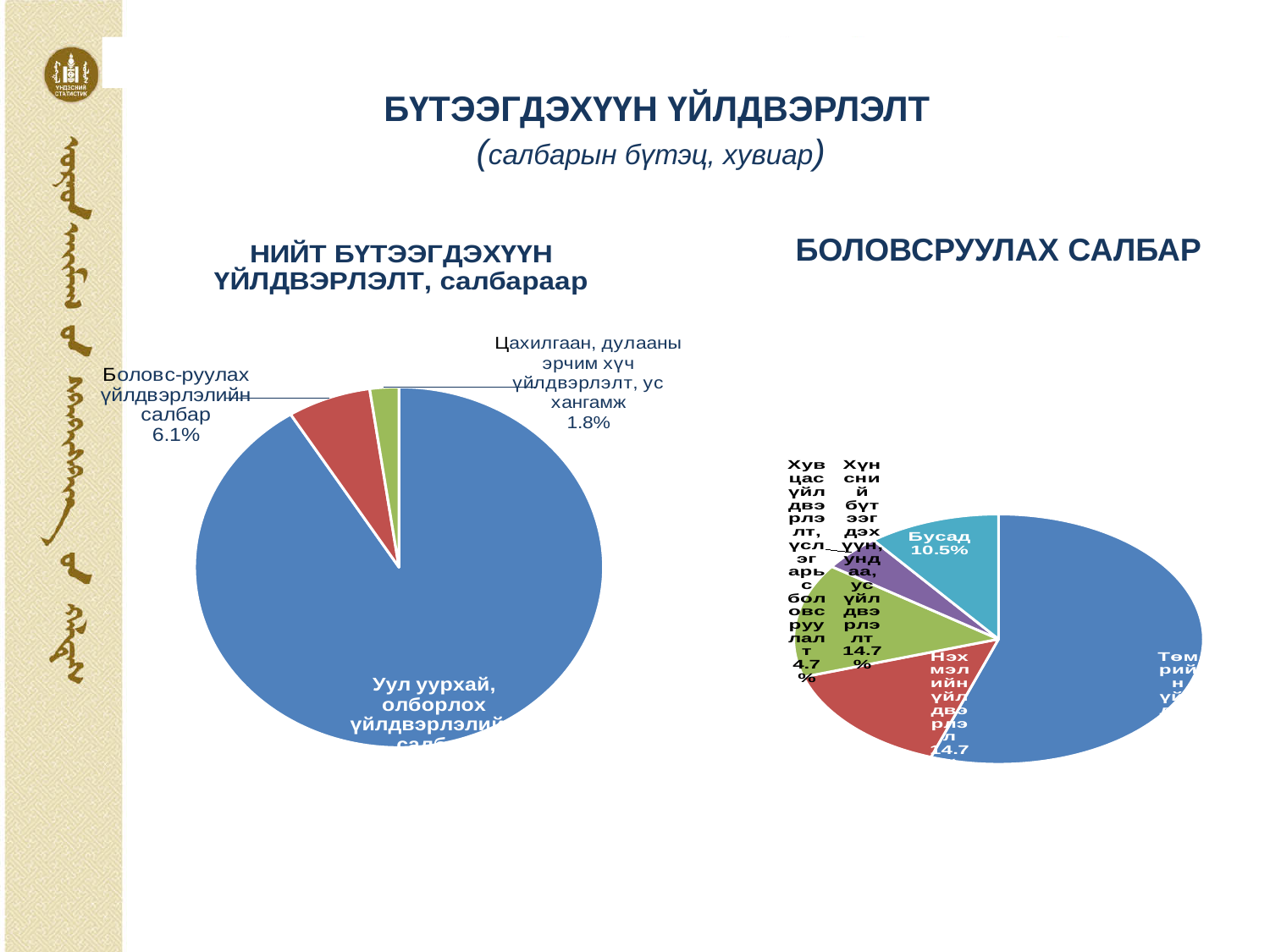
In the right chart 'БОЛОВСРУУЛАХ САЛБАР', what share does 'Хувцас үйлдвэрлэлт, үслэг арьс боловсруулалт' have? 4.7% In the left chart 'НИЙТ БҮТЭЭГДЭХҮҮН ҮЙЛДВЭРЛЭЛТ, салбараар', how many slices does the pie have? 3 In the left chart 'НИЙТ БҮТЭЭГДЭХҮҮН ҮЙЛДВЭРЛЭЛТ, салбараар', what share does 'Цахилгаан, дулааны эрчим хүч үйлдвэрлэлт, ус хангамж' have? 1.8% In the right chart 'БОЛОВСРУУЛАХ САЛБАР', which is larger: the share of 'Бусад' or the share of 'Хувцас үйлдвэрлэлт, үслэг арьс боловсруулалт'? Бусад In the left chart 'НИЙТ БҮТЭЭГДЭХҮҮН ҮЙЛДВЭРЛЭЛТ, салбараар', what share does 'Боловсруулах үйлдвэрлэлийн салбар' have? 6.1% What type of chart is the left chart titled 'НИЙТ БҮТЭЭГДЭХҮҮН ҮЙЛДВЭРЛЭЛТ, салбараар'? Pie chart In the right chart 'БОЛОВСРУУЛАХ САЛБАР', how many slices does the pie have? 5 In the left chart 'НИЙТ БҮТЭЭГДЭХҮҮН ҮЙЛДВЭРЛЭЛТ, салбараар', what is the difference between the shares of 'Боловсруулах үйлдвэрлэлийн салбар' and 'Цахилгаан, дулааны эрчим хүч үйлдвэрлэлт, ус хангамж'? 4.3% In the right chart 'БОЛОВСРУУЛАХ САЛБАР', what share does 'Бусад' have? 10.5% In the left chart 'НИЙТ БҮТЭЭГДЭХҮҮН ҮЙЛДВЭРЛЭЛТ, салбараар', which sector has the largest slice? Уул уурхай, олборлох үйлдвэрлэлийн салбар In the right chart 'БОЛОВСРУУЛАХ САЛБАР', what share does 'Хүнсний бүтээгдэхүүн, ундаа, ус үйлдвэрлэлт' have? 14.7% In the left chart 'НИЙТ БҮТЭЭГДЭХҮҮН ҮЙЛДВЭРЛЭЛТ, салбараар', which sector has the smallest slice? Цахилгаан, дулааны эрчим хүч үйлдвэрлэлт, ус хангамж